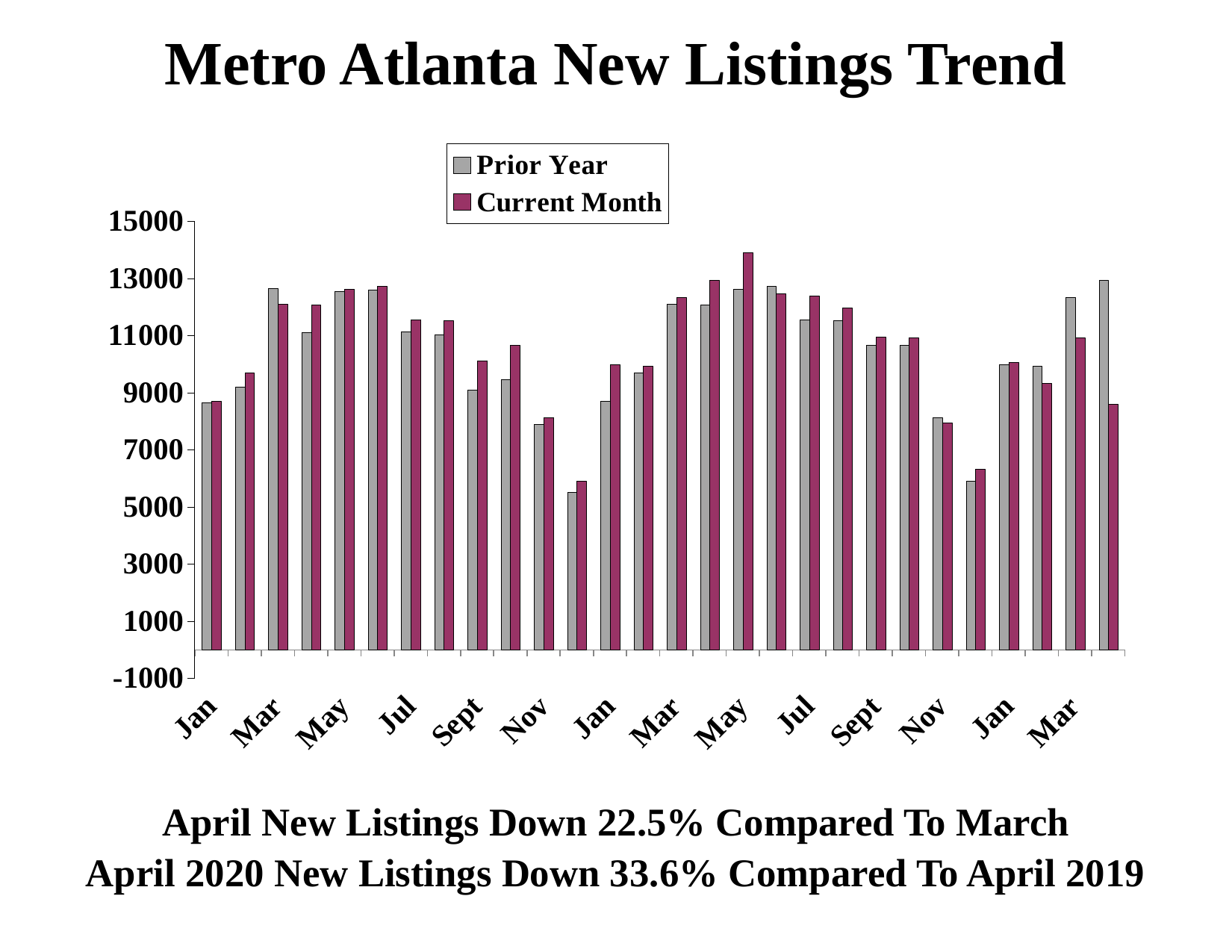
Is the Current Month value for the second Nov greater or less than 9000? less Is the Prior Year value for the first Mar greater or less than 11000? greater Is the Current Month value for the first Nov greater or less than 9000? less For the first Mar, which series has the larger value, Prior Year or Current Month? Prior Year Which series is shown in gray bars? Prior Year What is the title of the chart? Metro Atlanta New Listings Trend How many series does the legend list? 2 What kind of chart is shown on the slide? Bar chart Do the Current Month values rise or fall from the first Jan to the first Mar? rise For the second May, which series has the larger value, Prior Year or Current Month? Current Month